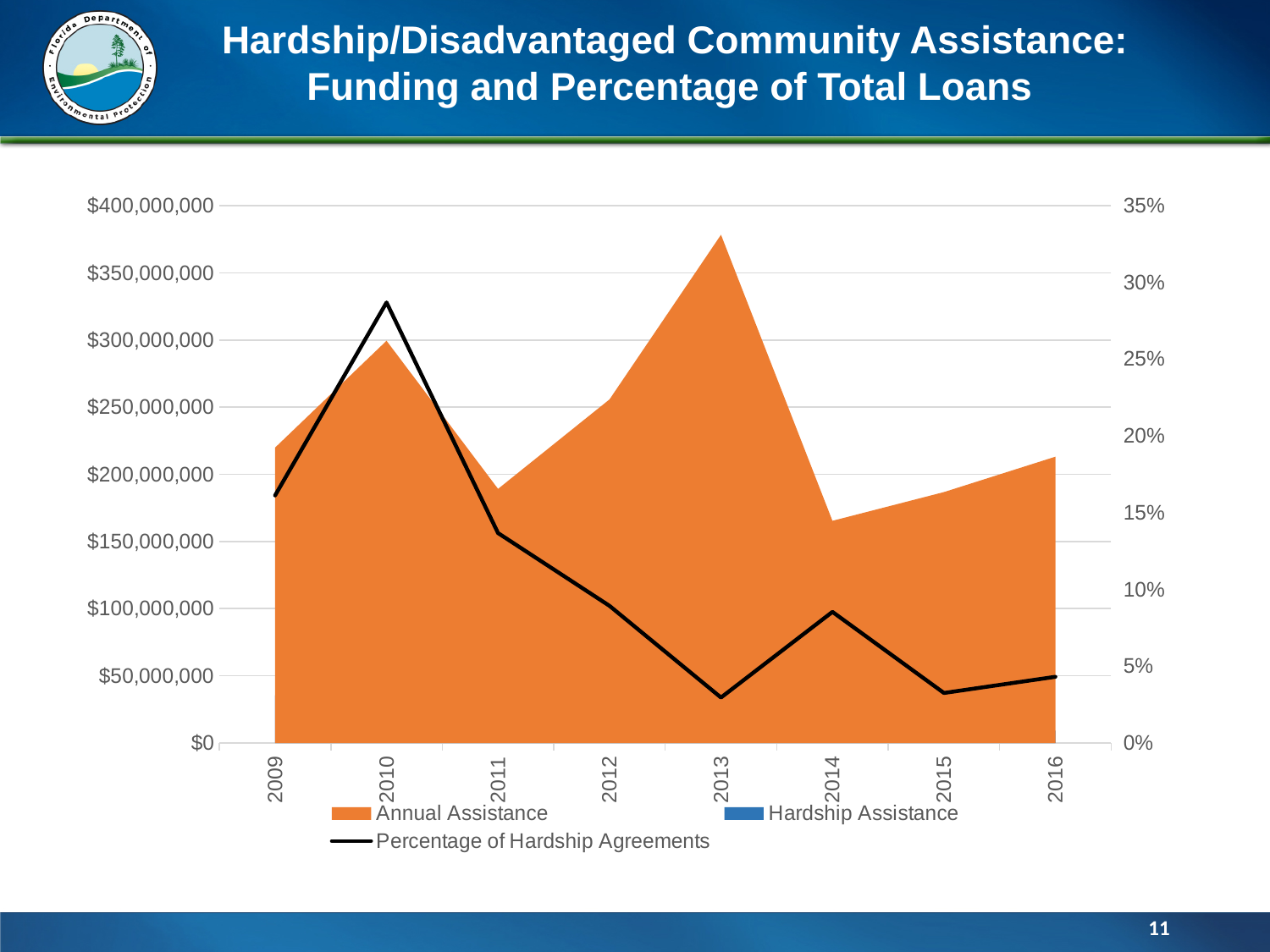
In which year is Annual Assistance highest? 2013 Is the Percentage of Hardship Agreements for 2013 greater or less than 5%? less In which year is the Percentage of Hardship Agreements highest? 2010 Is the Percentage of Hardship Agreements for 2010 greater or less than 25%? greater Which year has the larger Annual Assistance value, 2010 or 2013? 2013 How many series does the chart's legend list? 3 What type of chart is shown on the slide? A combination chart with an area series and a line series How many years are shown on the x axis of the chart? 8 Is the Annual Assistance value for 2013 greater or less than $350,000,000? greater In which year is Annual Assistance lowest? 2014 Does the Percentage of Hardship Agreements rise or fall from 2010 to 2013? fall